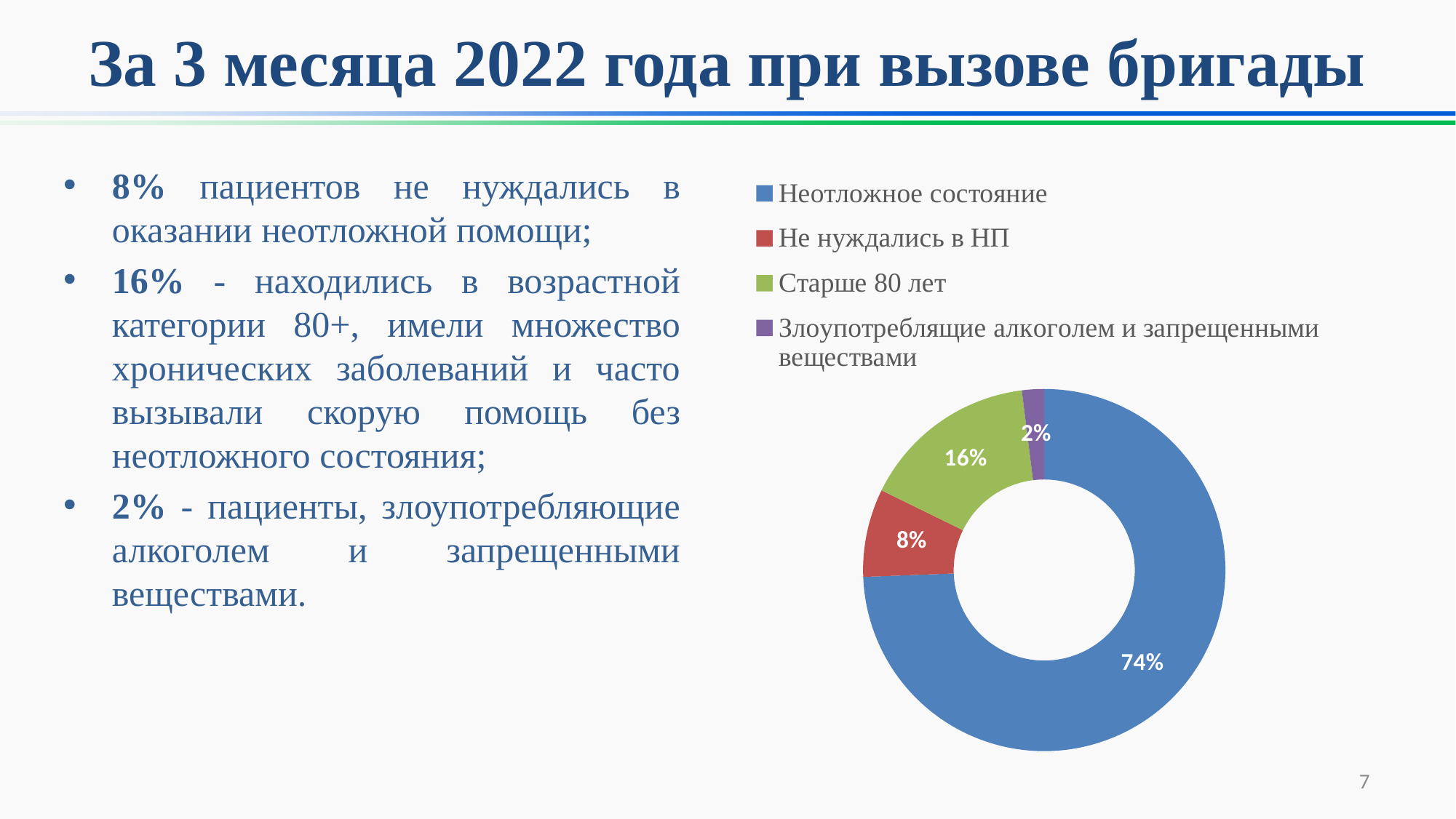
What share of the chart does "Злоупотреблящие алкоголем и запрещенными веществами" represent? 2% What type of chart is shown on the slide? Doughnut (pie) chart What colour is the slice for "Старше 80 лет"? Green What share of the chart does "Неотложное состояние" represent? 74% Which is larger: the share for "Старше 80 лет" or the share for "Не нуждались в НП"? Старше 80 лет How many categories does the legend list? 4 What is the combined share of "Не нуждались в НП" and "Злоупотреблящие алкоголем и запрещенными веществами"? 10% What share of the chart does "Старше 80 лет" represent? 16% What share of the chart does "Не нуждались в НП" represent? 8% What is the difference in percentage points between "Старше 80 лет" and "Не нуждались в НП"? 8 percentage points Which category has the largest share of the chart? Неотложное состояние Which category has the smallest share of the chart? Злоупотреблящие алкоголем и запрещенными веществами